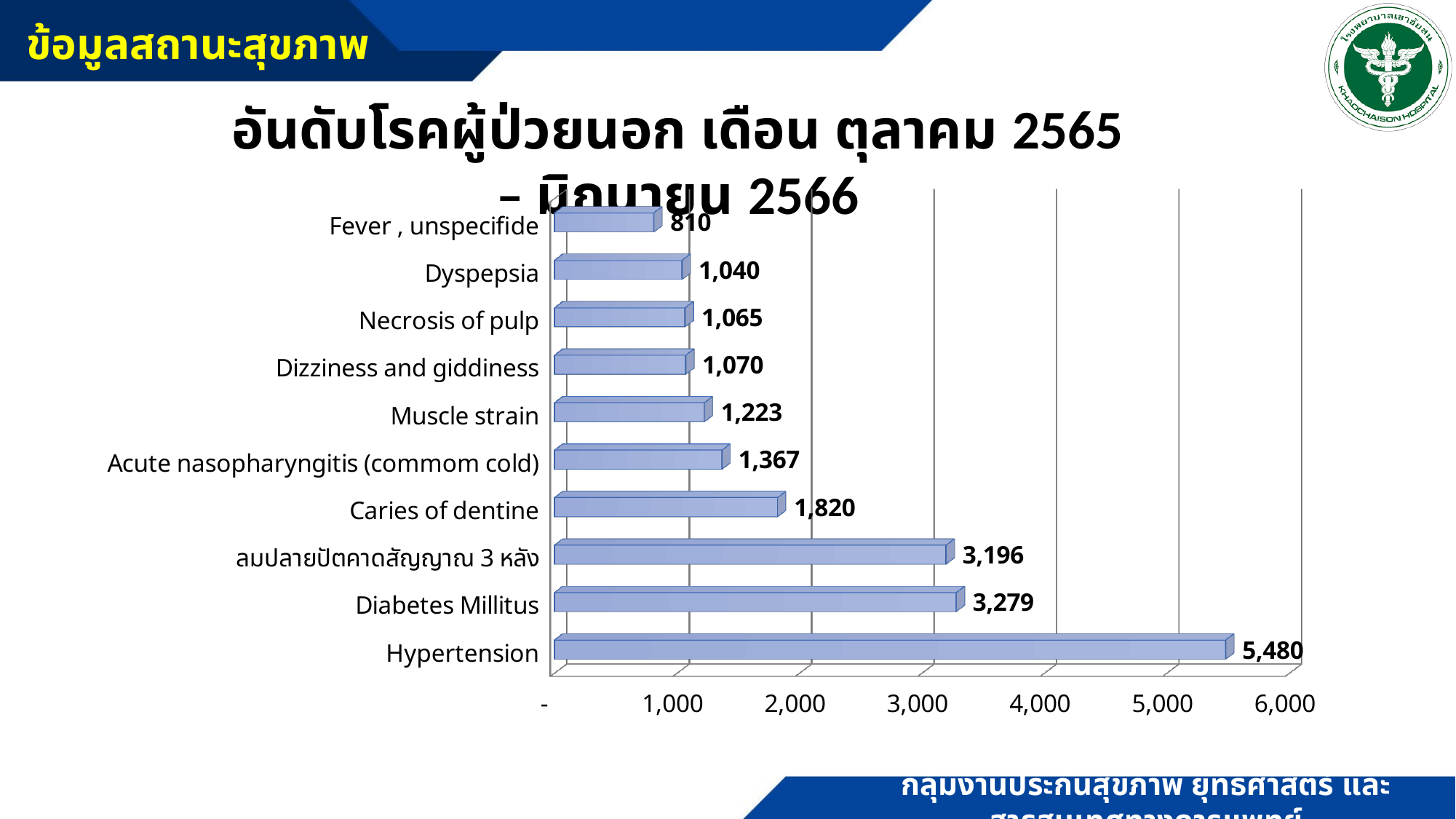
How many categories are shown in the chart? 10 Which is larger, the value for Muscle strain or the value for Caries of dentine? Caries of dentine What is the value for Hypertension? 5,480 Which category has the lowest value? Fever , unspecifide Which category has the highest value? Hypertension What is the value for Caries of dentine? 1,820 Is the value for Diabetes Millitus greater or less than 3,000? greater What is the difference between the values for Hypertension and Diabetes Millitus? 2,201 What is the difference between the values for Caries of dentine and Acute nasopharyngitis (commom cold)? 453 What kind of chart is shown on the slide? Bar chart What is the value for Dyspepsia? 1,040 What is the value for Acute nasopharyngitis (commom cold)? 1,367